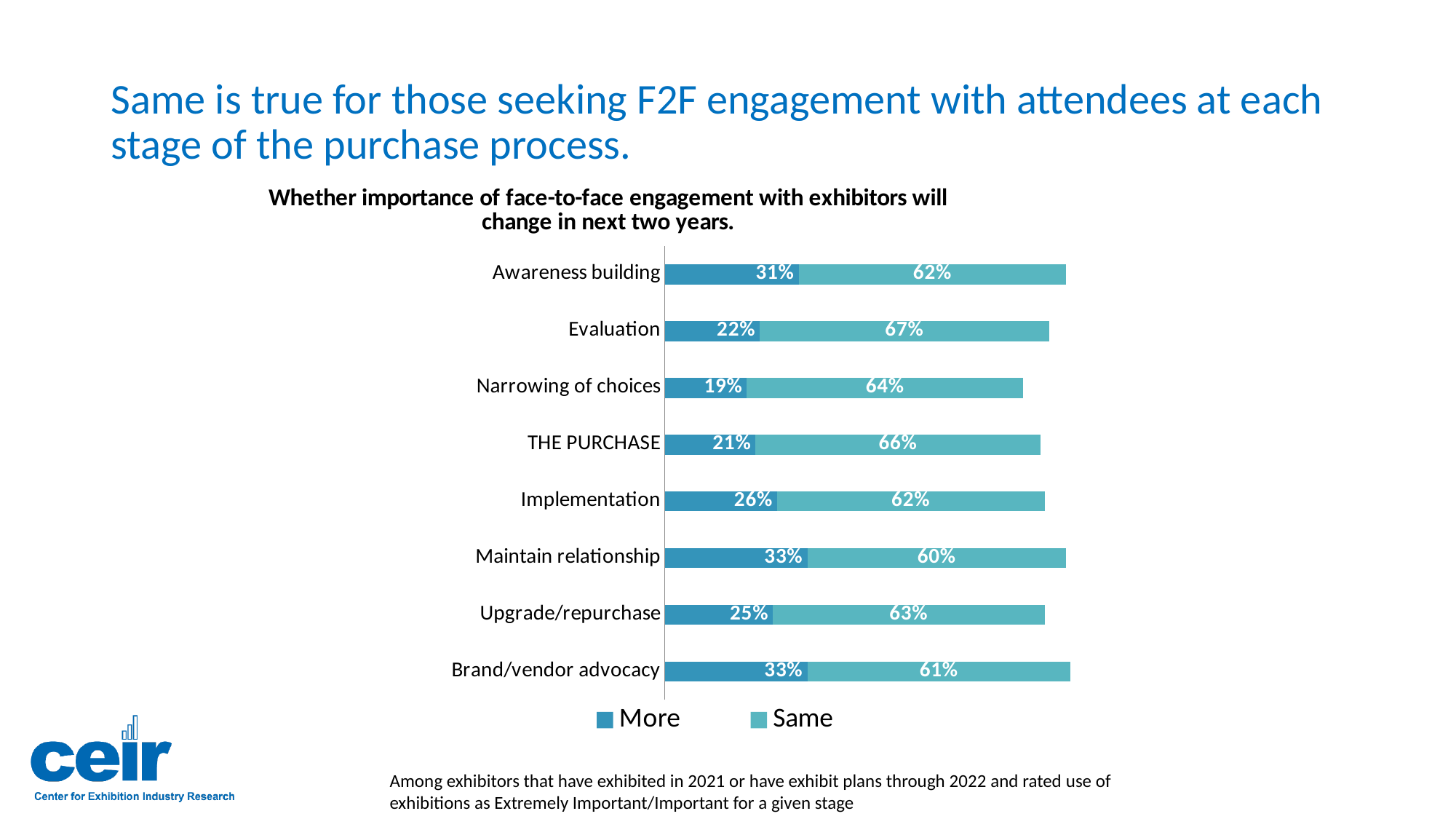
What is the 'More' value for Upgrade/repurchase? 25% What is the total of the stacked bar for Brand/vendor advocacy? 94% What is the 'More' value for Awareness building? 31% Which category has the highest 'Same' value? Evaluation What is the 'Same' value for Evaluation? 67% How many series does the legend list? 2 Which category has the lowest 'Same' value? Maintain relationship Which is larger: the 'More' value for Implementation or the 'More' value for Evaluation? Implementation Which category has the lowest 'More' value? Narrowing of choices What is the difference between the 'Same' value for THE PURCHASE and the 'More' value for THE PURCHASE? 45% How many categories (purchase stages) are plotted in the chart? 8 What kind of chart is shown on the slide? Stacked bar chart